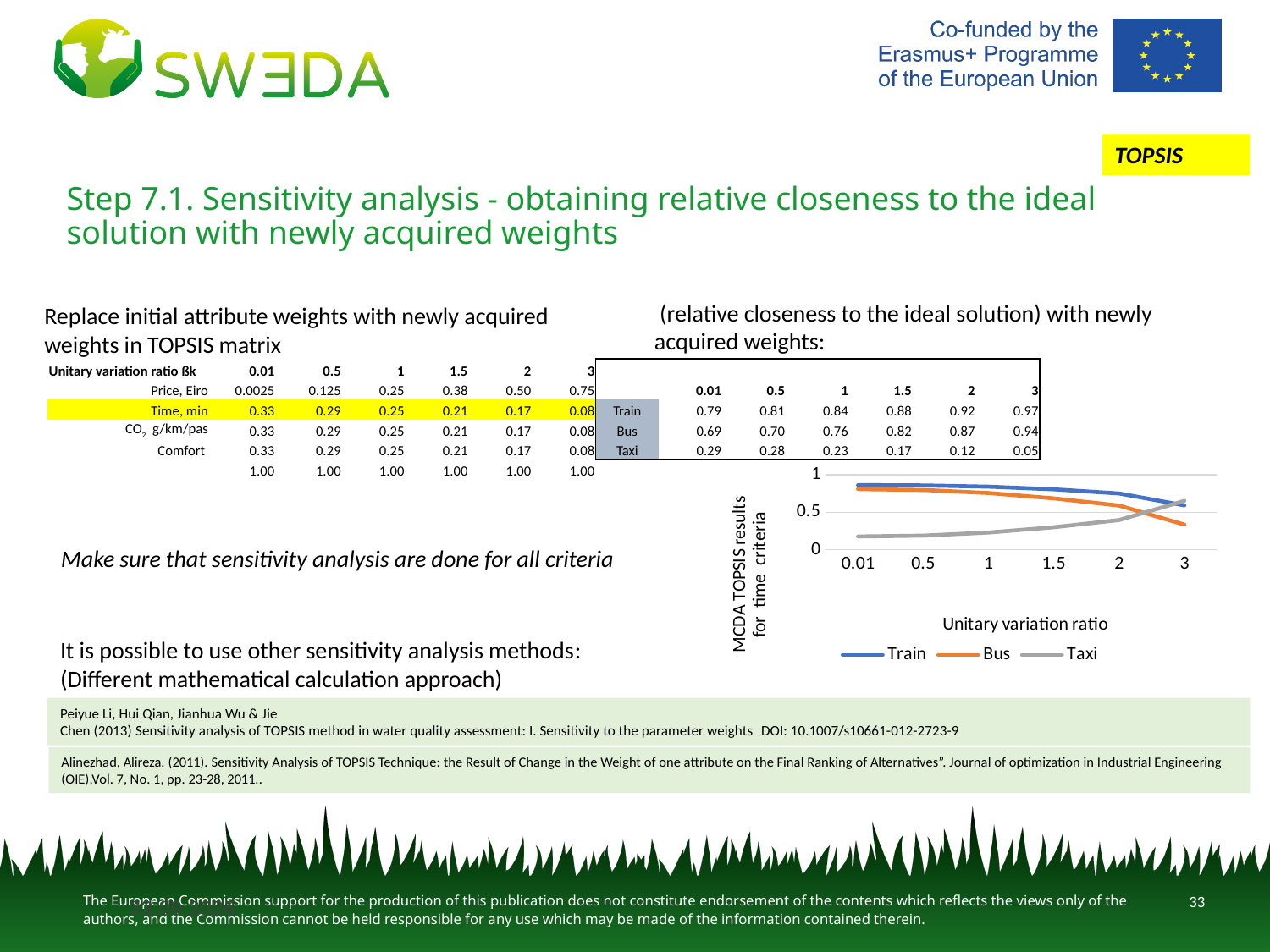
At a unitary variation ratio of 1, which is larger, the value for Bus or the value for Taxi? Bus What kind of chart is shown on the slide? line chart Does the Bus series rise or fall as the unitary variation ratio increases? fall How many series does the chart legend list? 3 Is the value for Train at a unitary variation ratio of 0.01 greater or less than 0.5? greater Which series has the lowest value at a unitary variation ratio of 3? Bus Does the Taxi series rise or fall as the unitary variation ratio increases? rise How many points are shown along the x axis of the chart? 6 What is the title of the x axis of the chart? Unitary variation ratio Which series has the lowest value at a unitary variation ratio of 0.01? Taxi Is the value for Taxi at a unitary variation ratio of 0.01 greater or less than 0.5? less Is the value for Bus at a unitary variation ratio of 3 greater or less than 0.5? less